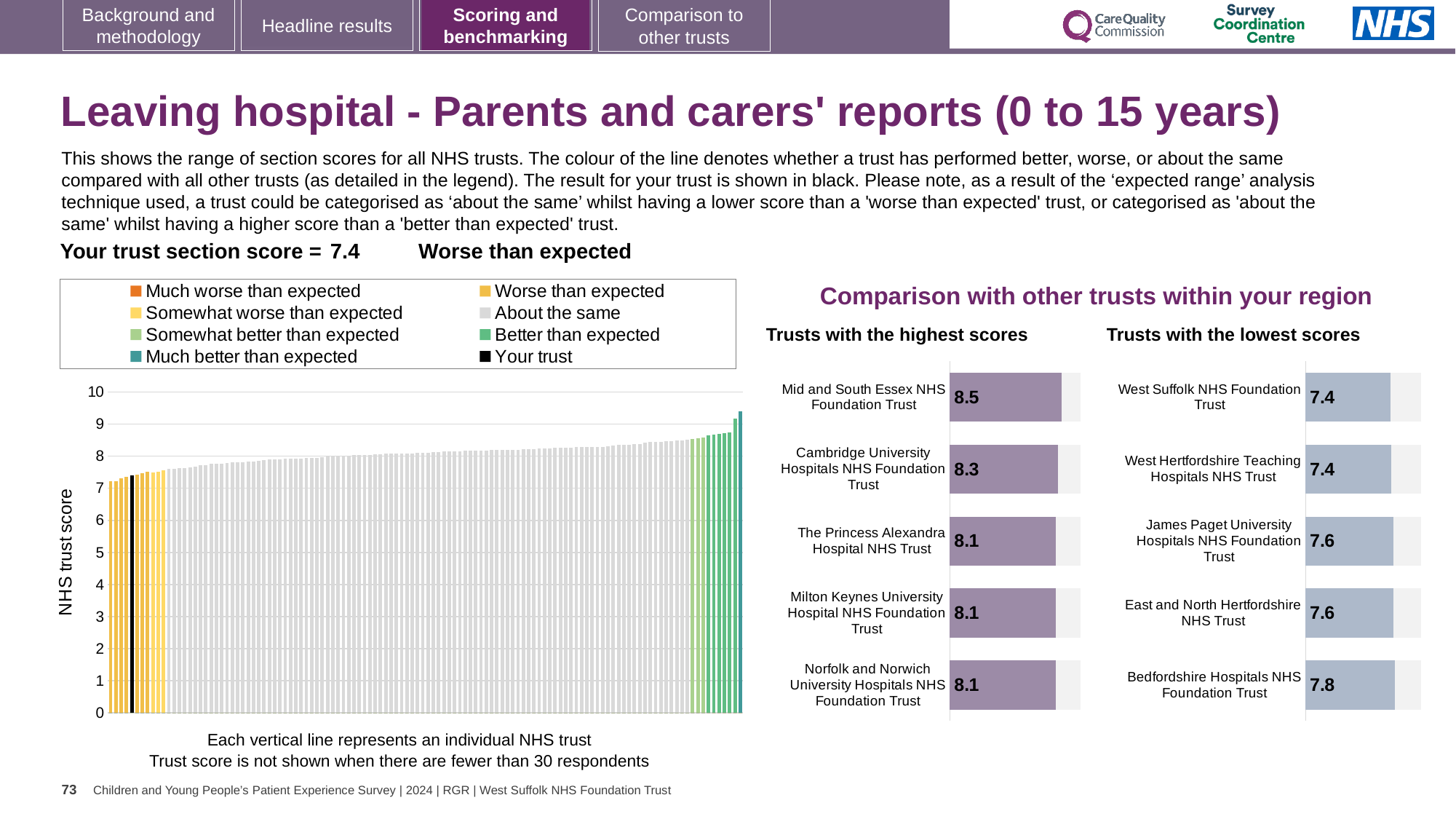
How many trusts are listed in the 'Trusts with the highest scores' chart? 5 In the 'Trusts with the lowest scores' chart, what is the score for Bedfordshire Hospitals NHS Foundation Trust? 7.8 In the 'Trusts with the highest scores' chart, what is the score for Mid and South Essex NHS Foundation Trust? 8.5 In the 'Trusts with the lowest scores' chart, what is the difference between the scores of Bedfordshire Hospitals NHS Foundation Trust and West Suffolk NHS Foundation Trust? 0.4 How many entries does the legend of the large chart on the left list? 8 In the 'Trusts with the lowest scores' chart, which has the larger score: Bedfordshire Hospitals NHS Foundation Trust or East and North Hertfordshire NHS Trust? Bedfordshire Hospitals NHS Foundation Trust In the 'Trusts with the highest scores' chart, which trust has the highest score? Mid and South Essex NHS Foundation Trust In the 'Trusts with the highest scores' chart, what is the score for Cambridge University Hospitals NHS Foundation Trust? 8.3 In the 'Trusts with the lowest scores' chart, what is the score for James Paget University Hospitals NHS Foundation Trust? 7.6 In the 'Trusts with the highest scores' chart, what is the difference between the scores of Mid and South Essex NHS Foundation Trust and Cambridge University Hospitals NHS Foundation Trust? 0.2 In the large chart on the left showing all NHS trusts, is the value of the tallest bar greater or less than 9? greater In the 'Trusts with the lowest scores' chart, which trust has the highest score? Bedfordshire Hospitals NHS Foundation Trust